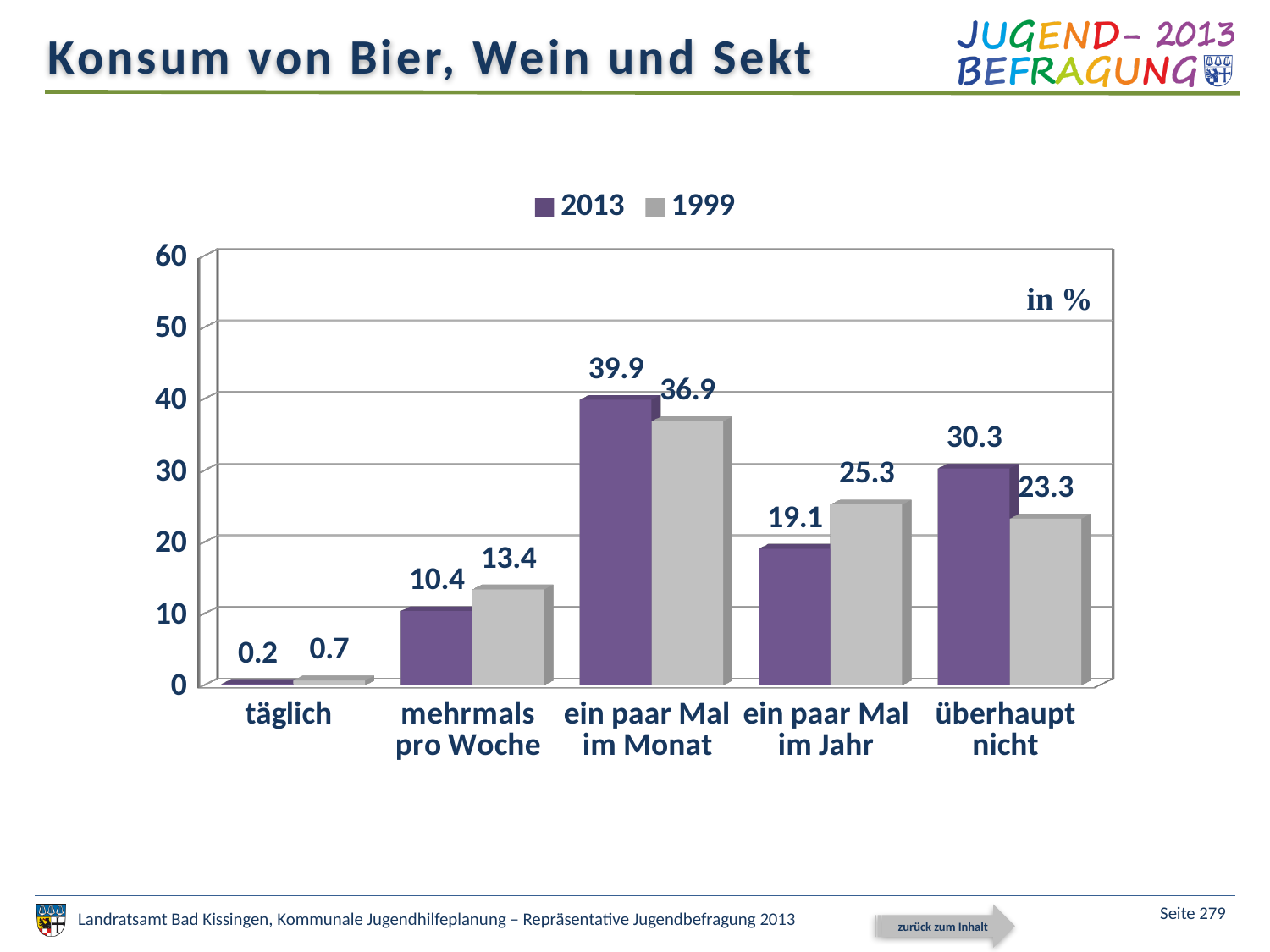
What is the value for 2013 in the 'ein paar Mal im Monat' category? 39.9 How many categories are shown on the x axis? 5 Which is larger in the 'mehrmals pro Woche' category, the 2013 value or the 1999 value? 1999 Is the 2013 value for 'überhaupt nicht' greater or less than 20? greater What is the difference between the 2013 and 1999 values for 'überhaupt nicht'? 7.0 Which category has the highest value for the 2013 series? ein paar Mal im Monat What is the value for 2013 in the 'täglich' category? 0.2 Which series is shown in purple according to the legend? 2013 What is the value for 1999 in the 'ein paar Mal im Jahr' category? 25.3 How many series does the legend list? 2 What kind of chart is shown on the slide? bar chart Which category has the lowest value for the 1999 series? täglich